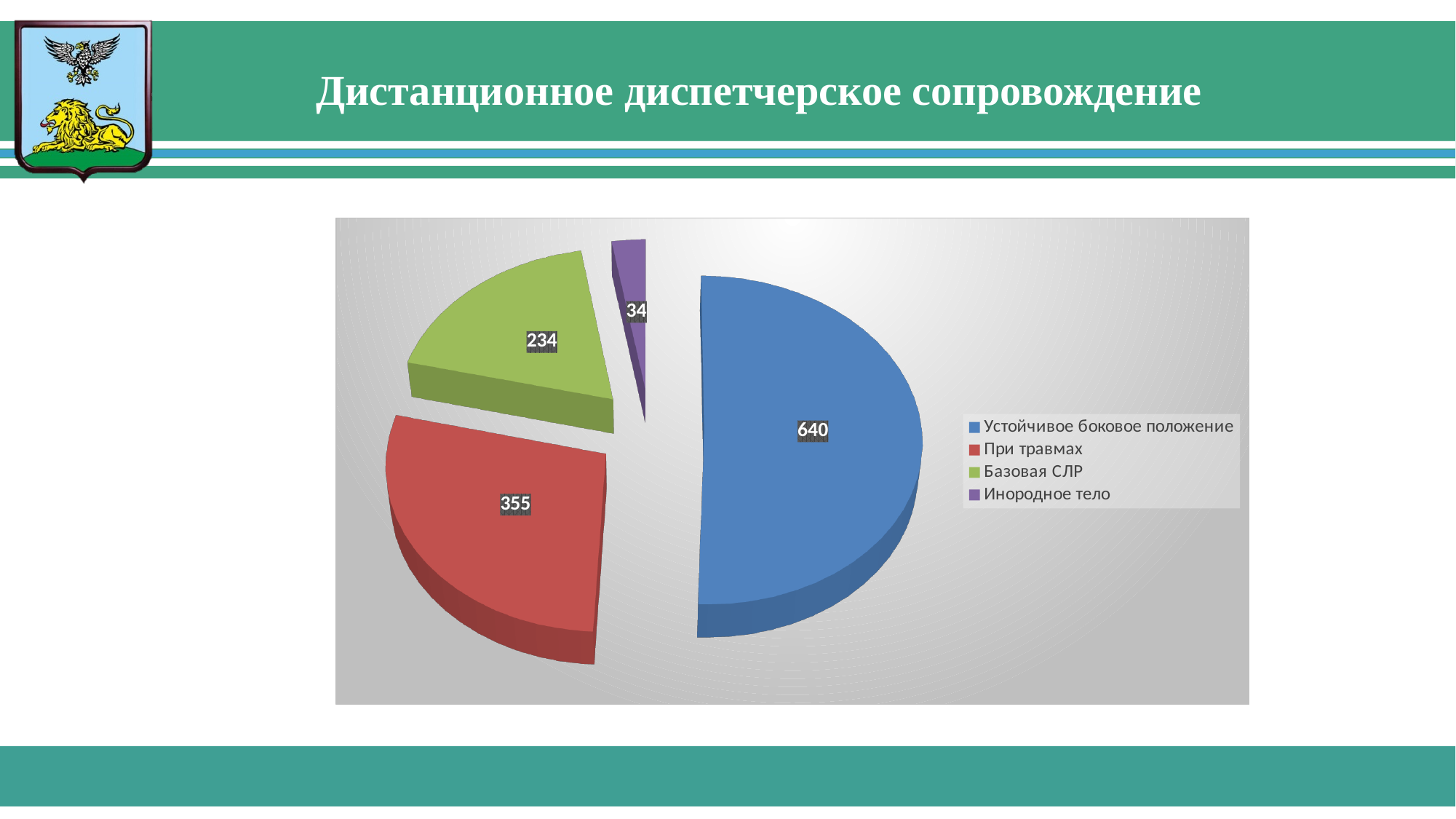
What is the difference between the values for Устойчивое боковое положение and При травмах? 285 What type of chart is shown on the slide? Pie chart Which category has the largest slice of the pie? Устойчивое боковое положение Which is larger, the value for При травмах or the value for Базовая СЛР? При травмах What colour is the slice for Базовая СЛР? Green What is the value for Устойчивое боковое положение? 640 What is the value for Инородное тело? 34 What is the difference between the values for Базовая СЛР and Инородное тело? 200 How many categories does the pie chart have? 4 Which category has the smallest slice of the pie? Инородное тело What is the value for Базовая СЛР? 234 What is the value for При травмах? 355